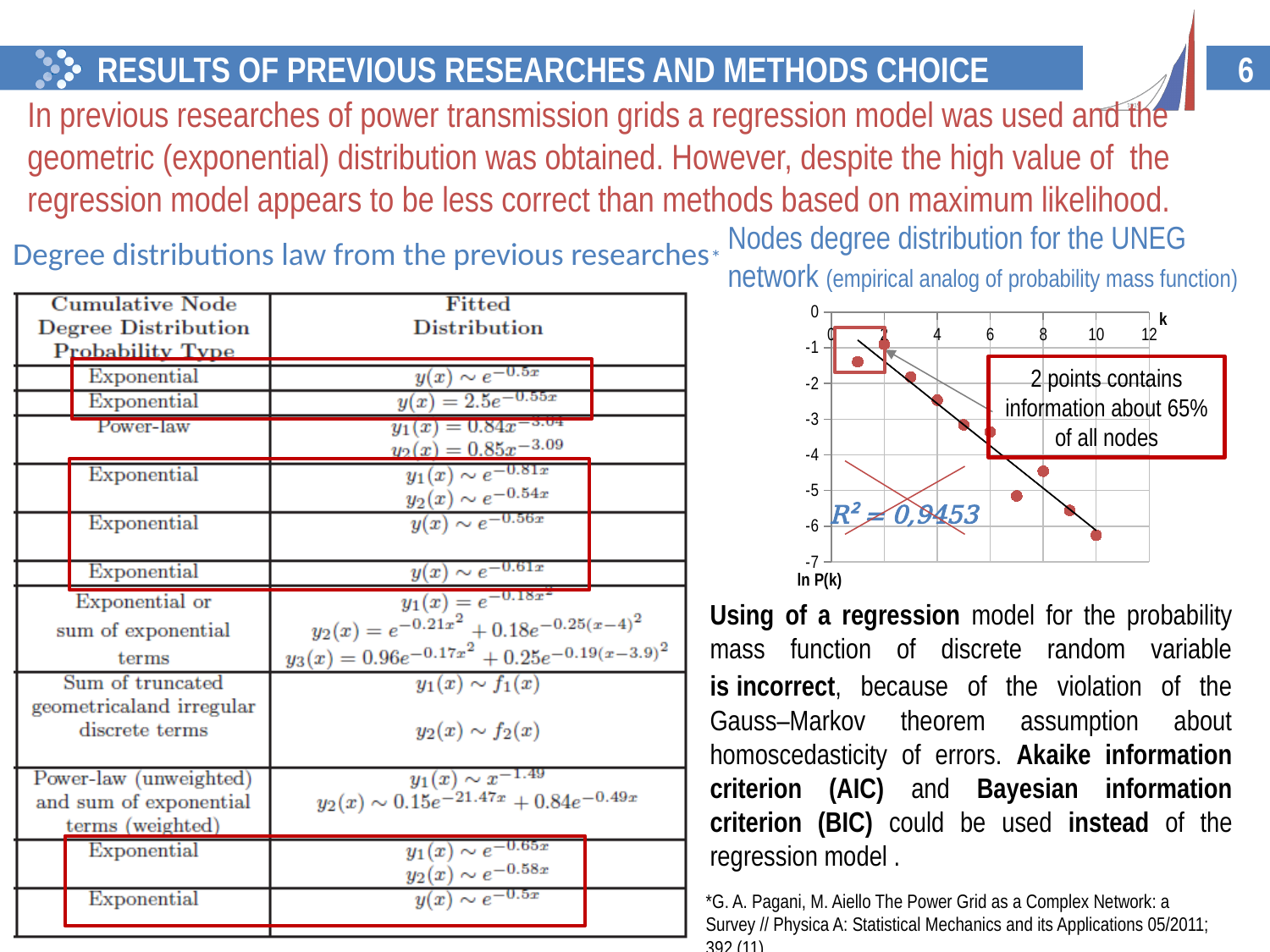
In the nodes degree distribution chart, which has the higher value of ln P(k): the point at k = 3 or the point at k = 4? k = 3 In the nodes degree distribution chart, is the value of ln P(k) at k = 6 greater or less than -4? greater In the nodes degree distribution chart, which has the higher value of ln P(k): the point at k = 7 or the point at k = 8? k = 8 In the nodes degree distribution chart, at which value of k is the lowest point plotted? 10 What kind of chart is used to show the nodes degree distribution for the UNEG network? scatter chart In the nodes degree distribution chart, is the value of ln P(k) at k = 2 greater or less than -2? greater In the nodes degree distribution chart, is the value of ln P(k) at k = 9 greater or less than -5? less How many data points are plotted in the nodes degree distribution chart? 10 What R² value is shown on the nodes degree distribution chart? 0,9453 In the nodes degree distribution chart, do the values of ln P(k) rise or fall as k increases? fall